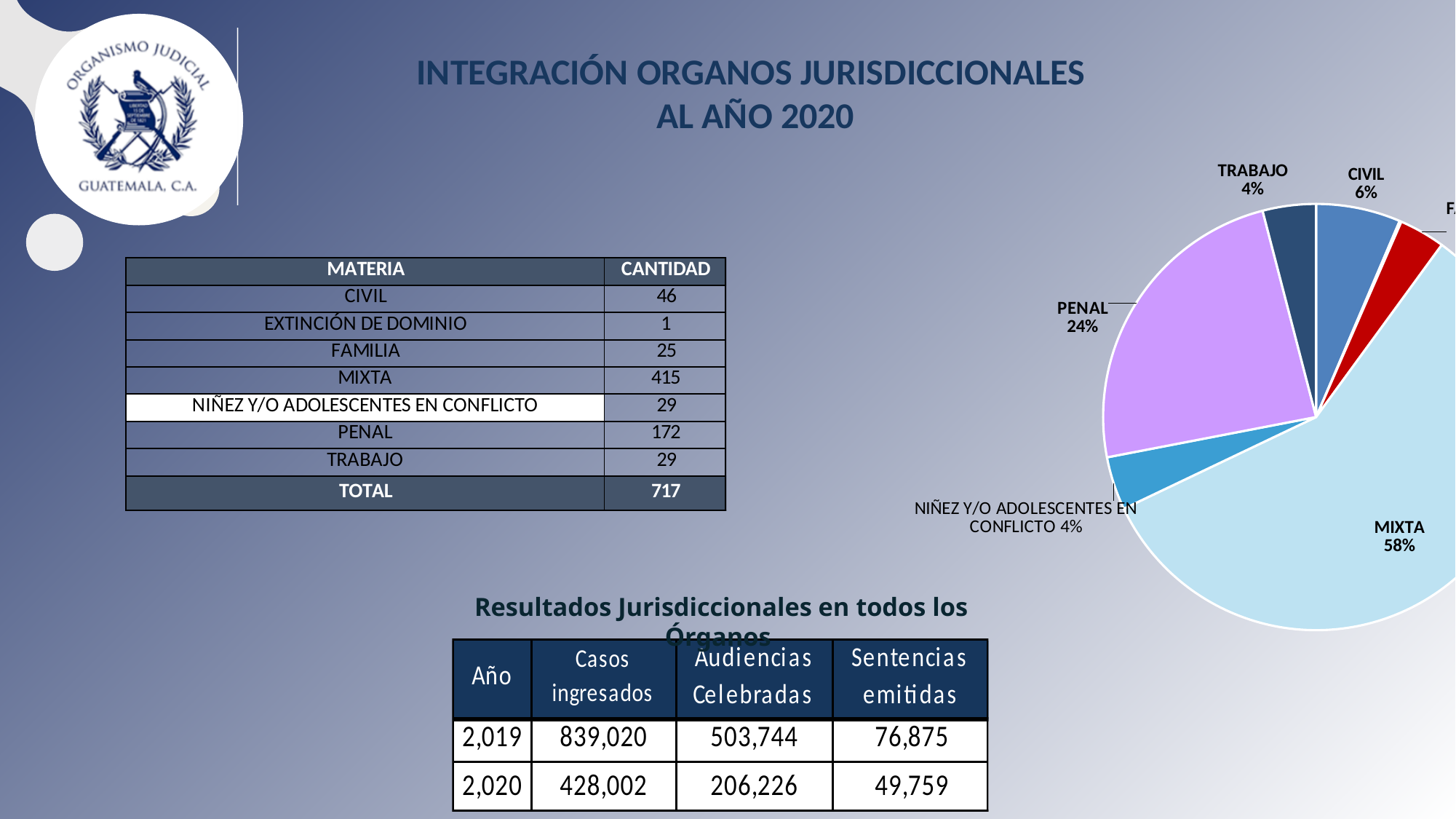
In the pie chart, what share does TRABAJO have? 4% In the pie chart, how many percentage points larger is PENAL than CIVIL? 18 percentage points In the pie chart, which is larger: CIVIL or TRABAJO? CIVIL In the pie chart, what share does MIXTA have? 58% In the pie chart, what share does PENAL have? 24% What kind of chart is shown on the right side of the slide? pie chart What colour is the MIXTA slice in the pie chart? light blue In the pie chart, how many percentage points larger is MIXTA than PENAL? 34 percentage points In the pie chart, which is larger: PENAL or CIVIL? PENAL Which slice of the pie chart is the largest? MIXTA